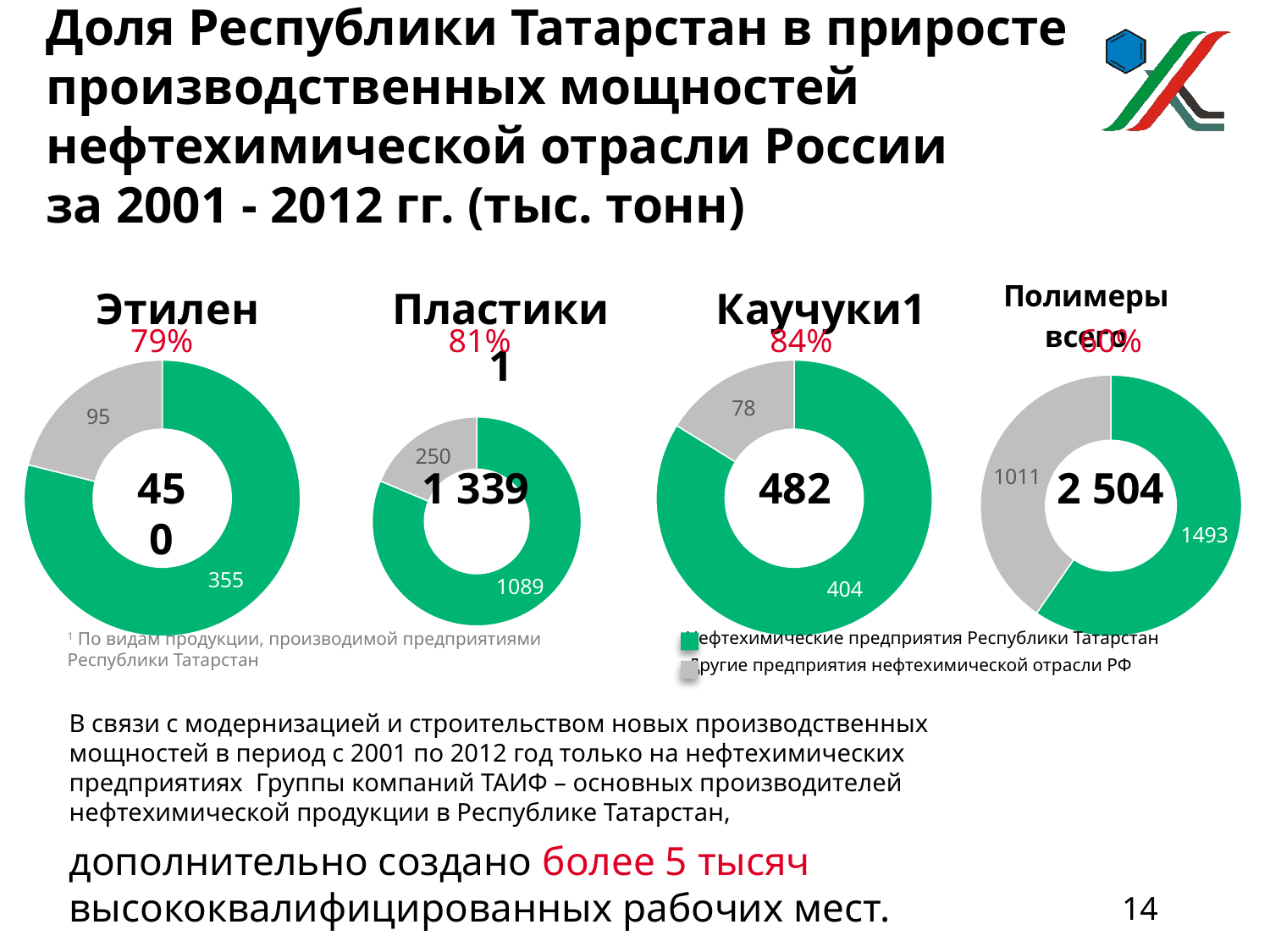
How many series does the legend list? 2 What is the total shown in the centre of the Пластики chart? 1 339 In the Пластики chart, what is the difference between the Татарстан value and the other RF enterprises value? 839 What kind of chart is used for Этилен? Donut (pie) chart What share of the Полимеры всего chart belongs to Нефтехимические предприятия Республики Татарстан? 60% What share of the Каучуки chart belongs to Нефтехимические предприятия Республики Татарстан? 84% In the Полимеры всего chart, what is the value for Другие предприятия нефтехимической отрасли РФ? 1011 In the Каучуки chart, what is the value for Нефтехимические предприятия Республики Татарстан? 404 In the Пластики chart, what is the value for Другие предприятия нефтехимической отрасли РФ? 250 In the Этилен chart, what is the value for Нефтехимические предприятия Республики Татарстан? 355 In the Этилен chart, what is the value for Другие предприятия нефтехимической отрасли РФ? 95 In the Полимеры всего chart, which segment is larger: Нефтехимические предприятия Республики Татарстан or Другие предприятия нефтехимической отрасли РФ? Нефтехимические предприятия Республики Татарстан